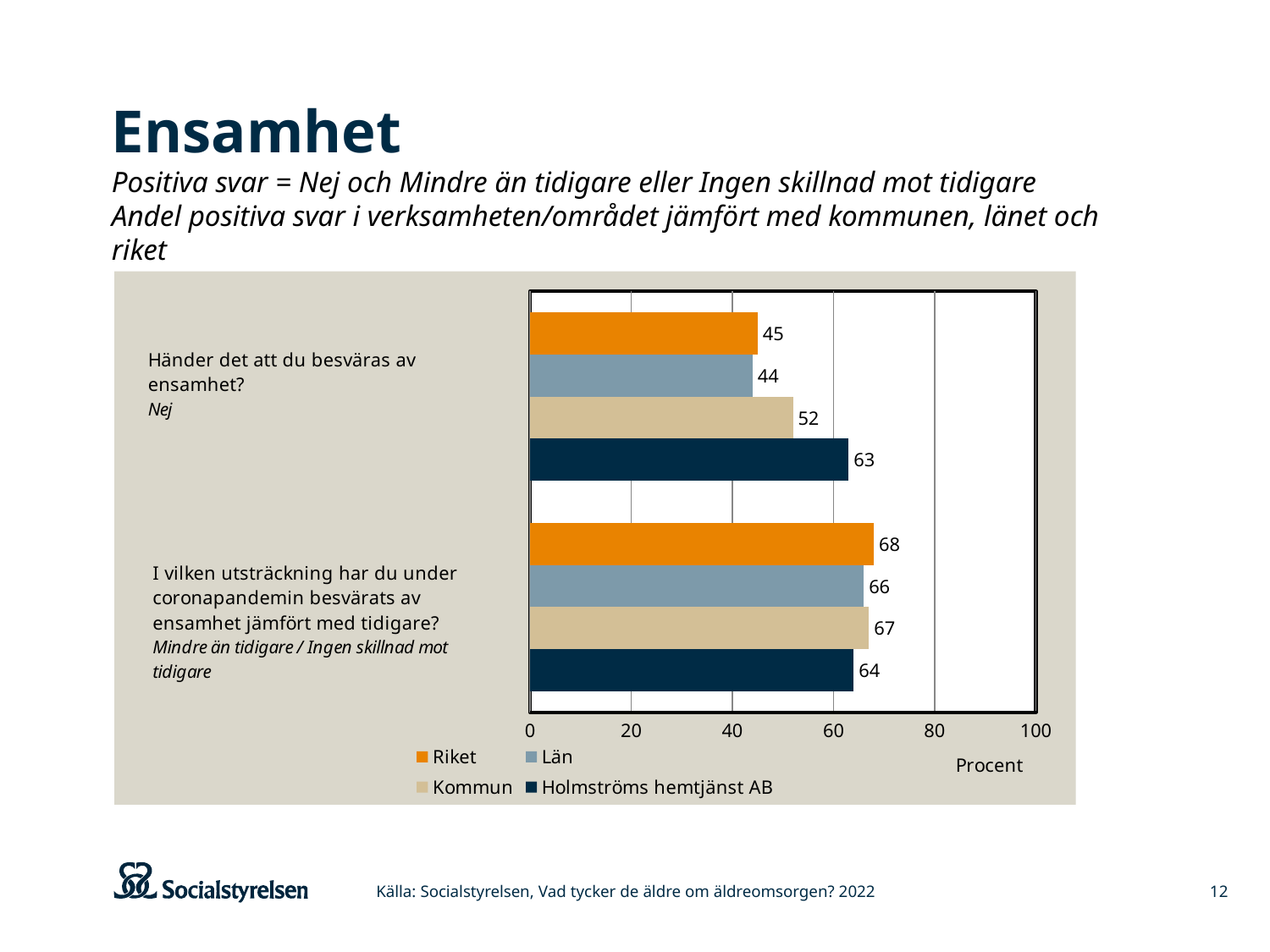
What is the label of the horizontal axis? Procent What is the value for Län on the question "Händer det att du besväras av ensamhet?"? 44 What kind of chart is shown on the slide? bar chart What is the difference between Holmströms hemtjänst AB and Riket on the question "Händer det att du besväras av ensamhet?"? 18 Which series has the lowest value on the question "I vilken utsträckning har du under coronapandemin besvärats av ensamhet jämfört med tidigare?"? Holmströms hemtjänst AB What is the value for Riket on the question "I vilken utsträckning har du under coronapandemin besvärats av ensamhet jämfört med tidigare?"? 68 Which is larger on the question "Händer det att du besväras av ensamhet?": Kommun or Län? Kommun Which series has the highest value on the question "Händer det att du besväras av ensamhet?"? Holmströms hemtjänst AB Is the value for Riket on the question "Händer det att du besväras av ensamhet?" greater or less than 60? less What is the value for Kommun on the question "I vilken utsträckning har du under coronapandemin besvärats av ensamhet jämfört med tidigare?"? 67 How many series does the legend list? 4 What is the value for Holmströms hemtjänst AB on the question "Händer det att du besväras av ensamhet?"? 63